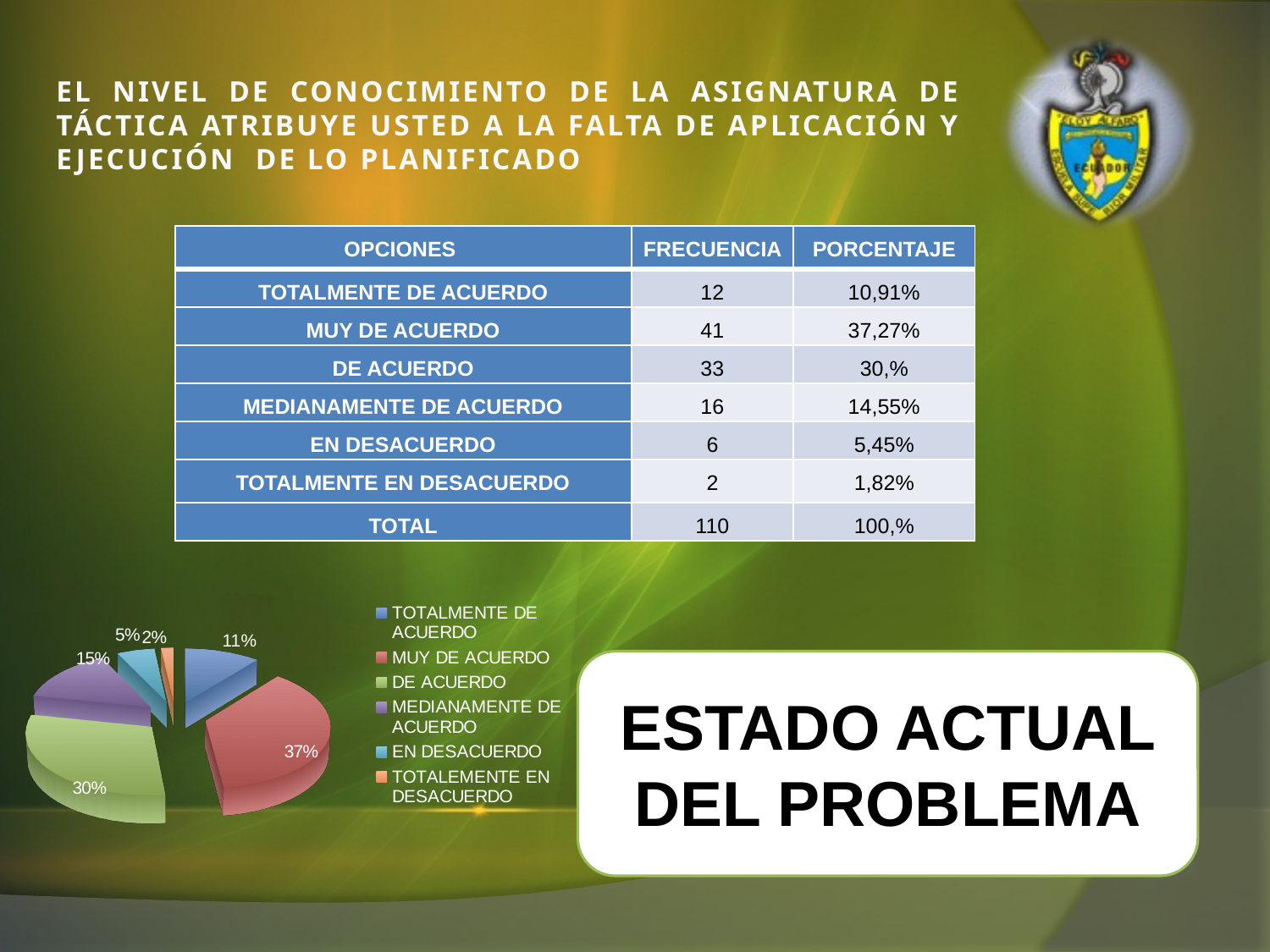
How many entries does the pie chart's legend list? 6 What colour is the MUY DE ACUERDO slice in the pie chart? Red Which category has the largest slice in the pie chart? MUY DE ACUERDO What percentage does the pie chart show for MEDIANAMENTE DE ACUERDO? 15% How many slices does the pie chart have? 6 What percentage does the pie chart show for MUY DE ACUERDO? 37% In the pie chart, which is larger: the slice for EN DESACUERDO or the slice for TOTALMENTE DE ACUERDO? TOTALMENTE DE ACUERDO In the pie chart, what is the difference in percentage points between MUY DE ACUERDO and DE ACUERDO? 7 What kind of chart is shown on the slide? Pie chart What percentage does the pie chart show for TOTALMENTE DE ACUERDO? 11% Which category has the smallest slice in the pie chart? TOTALEMENTE EN DESACUERDO What percentage does the pie chart show for DE ACUERDO? 30%